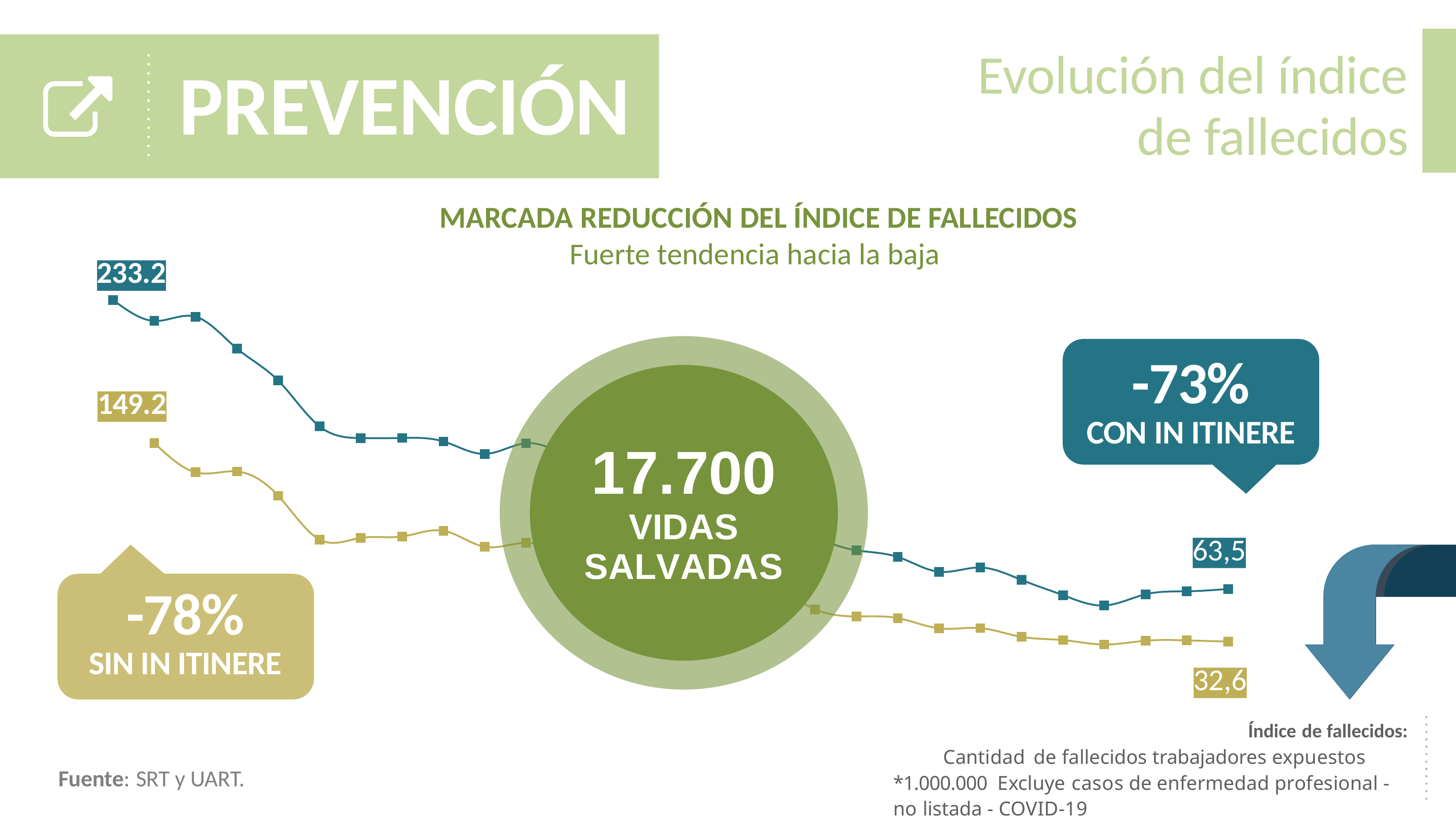
What percentage reduction is shown for CON IN ITINERE? -73% What is the starting value of the CON IN ITINERE (teal) line? 233.2 How many lines (series) are plotted on the chart? 2 What percentage reduction is shown for SIN IN ITINERE? -78% What is the final value of the CON IN ITINERE (teal) line? 63,5 What is the difference between the starting values of the two lines (233.2 and 149.2)? 84.0 Do the values of the lines rise or fall from left to right? fall What is the starting value of the SIN IN ITINERE (yellow) line? 149.2 What is the final value of the SIN IN ITINERE (yellow) line? 32,6 What kind of chart is shown on the slide? line chart Which line starts higher, CON IN ITINERE or SIN IN ITINERE? CON IN ITINERE What is the difference between the final values of the two lines (63,5 and 32,6)? 30,9